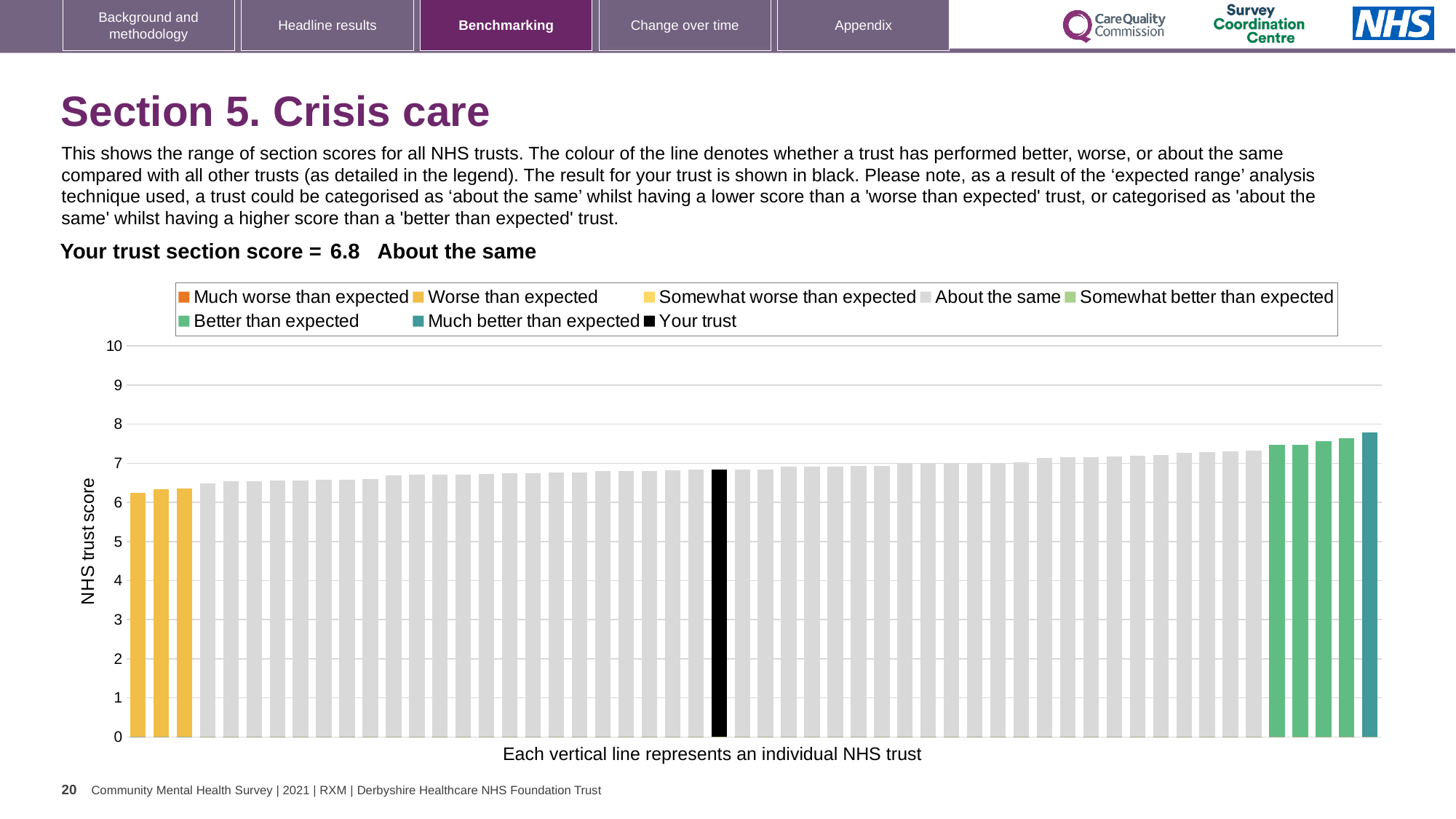
What is the trust's section score for Crisis care shown on the slide? 6.8 How many bars are coloured as 'Worse than expected' (yellow)? 3 How many entries does the chart legend list? 8 How many bars are coloured as 'Better than expected' (green)? 4 What is the label on the vertical axis of the chart? NHS trust score Which is larger: the value of the black 'Your trust' bar or the value of the leftmost yellow bar? the black 'Your trust' bar Is the value of the black 'Your trust' bar greater or less than 6? greater Which performance category is the trust's Crisis care section score placed in? About the same Is the value of the shortest bar in the chart greater or less than 6? greater What kind of chart is shown on the slide? bar chart Do the bar values rise or fall from left to right across the chart? rise Is the value of the tallest bar in the chart greater or less than 8? less